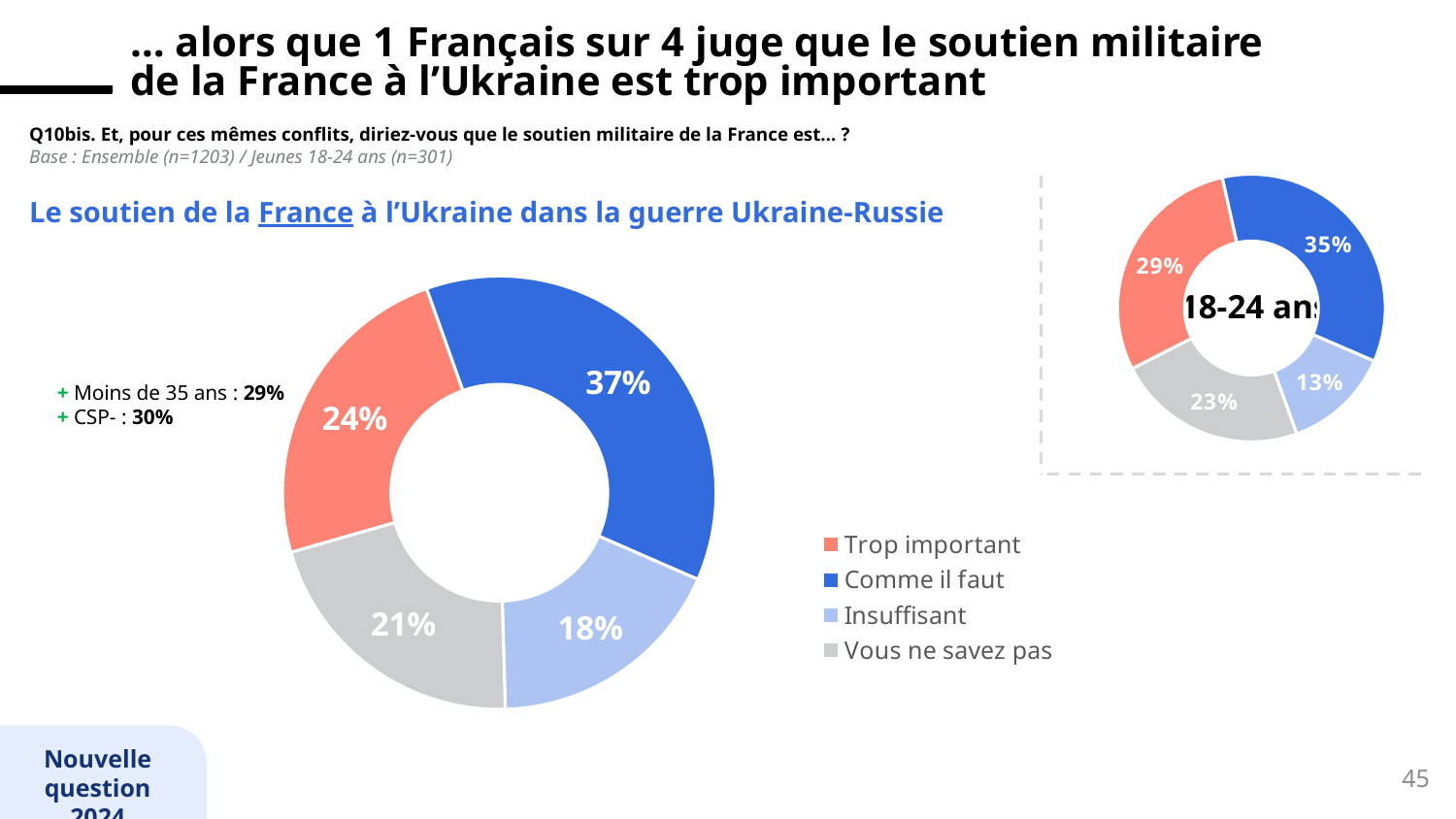
What kind of chart is used on this slide? Pie (donut) chart In the large donut chart on the left, what percentage corresponds to 'Trop important'? 24% In the small '18-24 ans' donut chart on the right, which category has the smallest share? Insuffisant In the small '18-24 ans' donut chart on the right, what percentage corresponds to 'Insuffisant'? 13% In the small '18-24 ans' donut chart on the right, what percentage corresponds to 'Comme il faut'? 35% In the large donut chart on the left, which category has the largest share? Comme il faut How many entries does the legend list? 4 In the large donut chart on the left, what percentage corresponds to 'Comme il faut'? 37% In the large donut chart on the left, what is the difference in percentage points between 'Comme il faut' and 'Trop important'? 13 Comparing the two donut charts, is the 'Trop important' share larger for the large chart on the left or for the '18-24 ans' chart on the right? 18-24 ans In the large donut chart on the left, what percentage corresponds to 'Vous ne savez pas'? 21% In the large donut chart on the left, what percentage corresponds to 'Insuffisant'? 18%